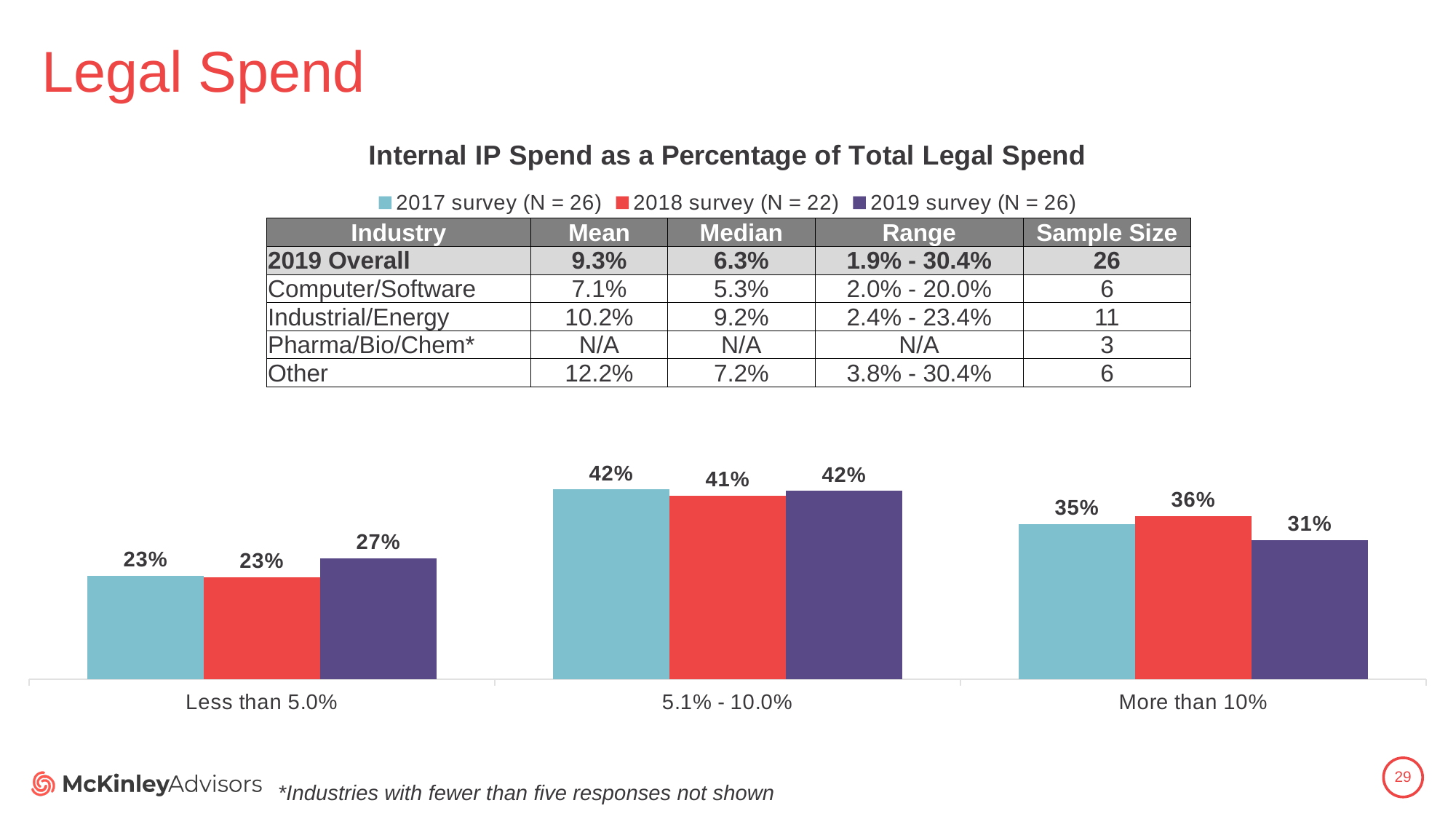
Which category has the highest value for the 2019 survey? 5.1% - 10.0% What kind of chart is shown on the slide? bar chart What is the difference between the 2018 survey and 2019 survey values in the 'More than 10%' category? 5% How many series does the chart legend list? 3 What is the title of the chart? Internal IP Spend as a Percentage of Total Legal Spend Which series is shown in red in the chart? 2018 survey (N = 22) How many categories are shown along the x axis of the chart? 3 What is the value for the 2019 survey in the 'Less than 5.0%' category? 27% Which category has the lowest value for the 2017 survey? Less than 5.0% What is the value for the 2017 survey in the 'More than 10%' category? 35% In the 'Less than 5.0%' category, which is larger: the 2017 survey value or the 2019 survey value? 2019 survey What is the value for the 2018 survey in the '5.1% - 10.0%' category? 41%